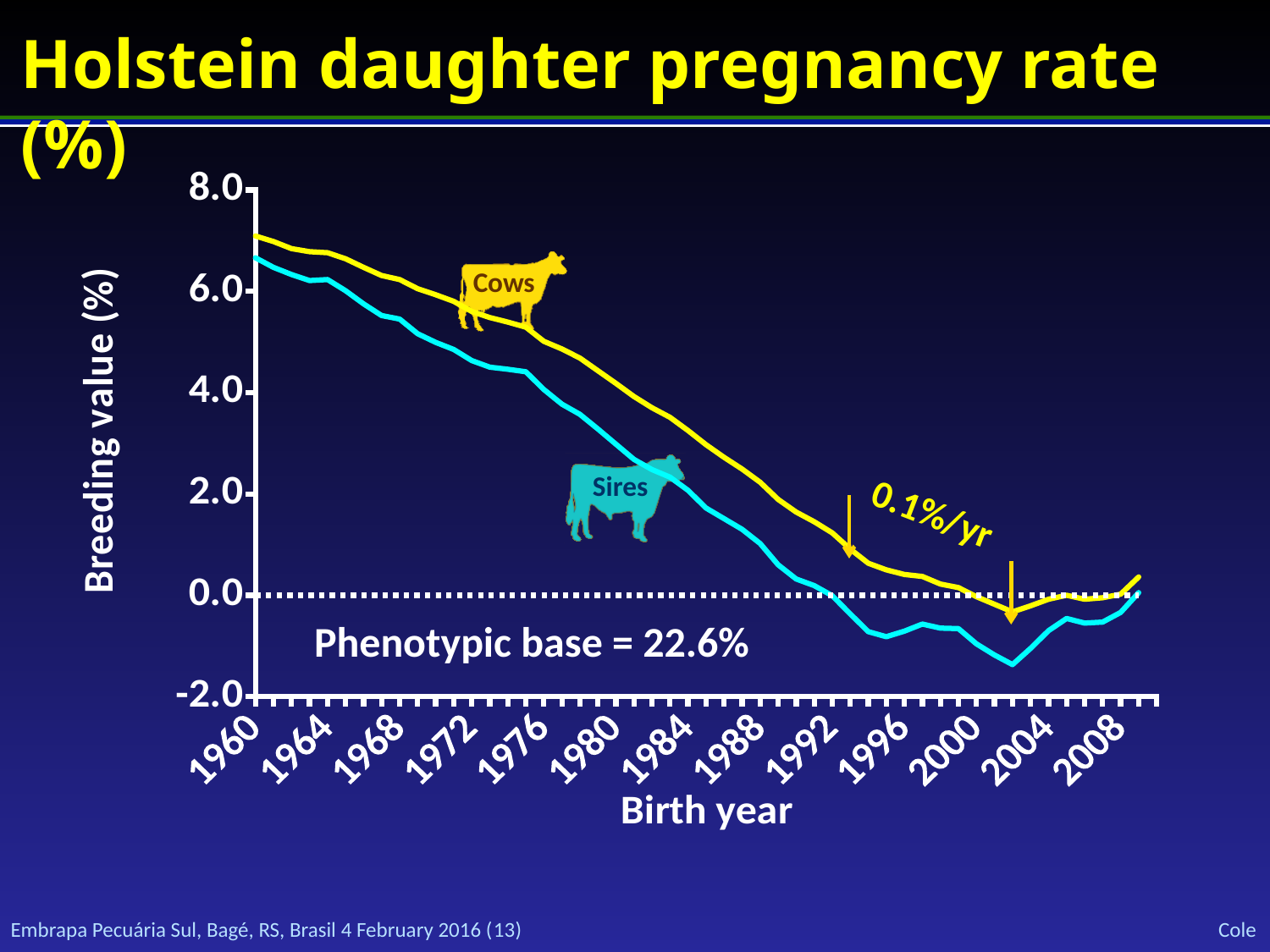
What is the label of the y axis? Breeding value (%) How many birth-year labels are shown on the x axis? 13 Is the breeding value for Cows in 1960 greater or less than 6.0? greater Do the breeding values for Cows rise or fall from 1960 to 2004? fall Is the breeding value for Sires in 2004 greater or less than 0.0? less Is the breeding value for Sires in 1996 greater or less than 0.0? less How many series are plotted on the chart? 3 What kind of chart is shown on the slide? line chart In 1984, which series has the higher breeding value, Cows or Sires? Cows What are the names of the two series plotted on the chart? Cows and Sires Do the breeding values for Sires rise or fall from 1960 to 2004? fall